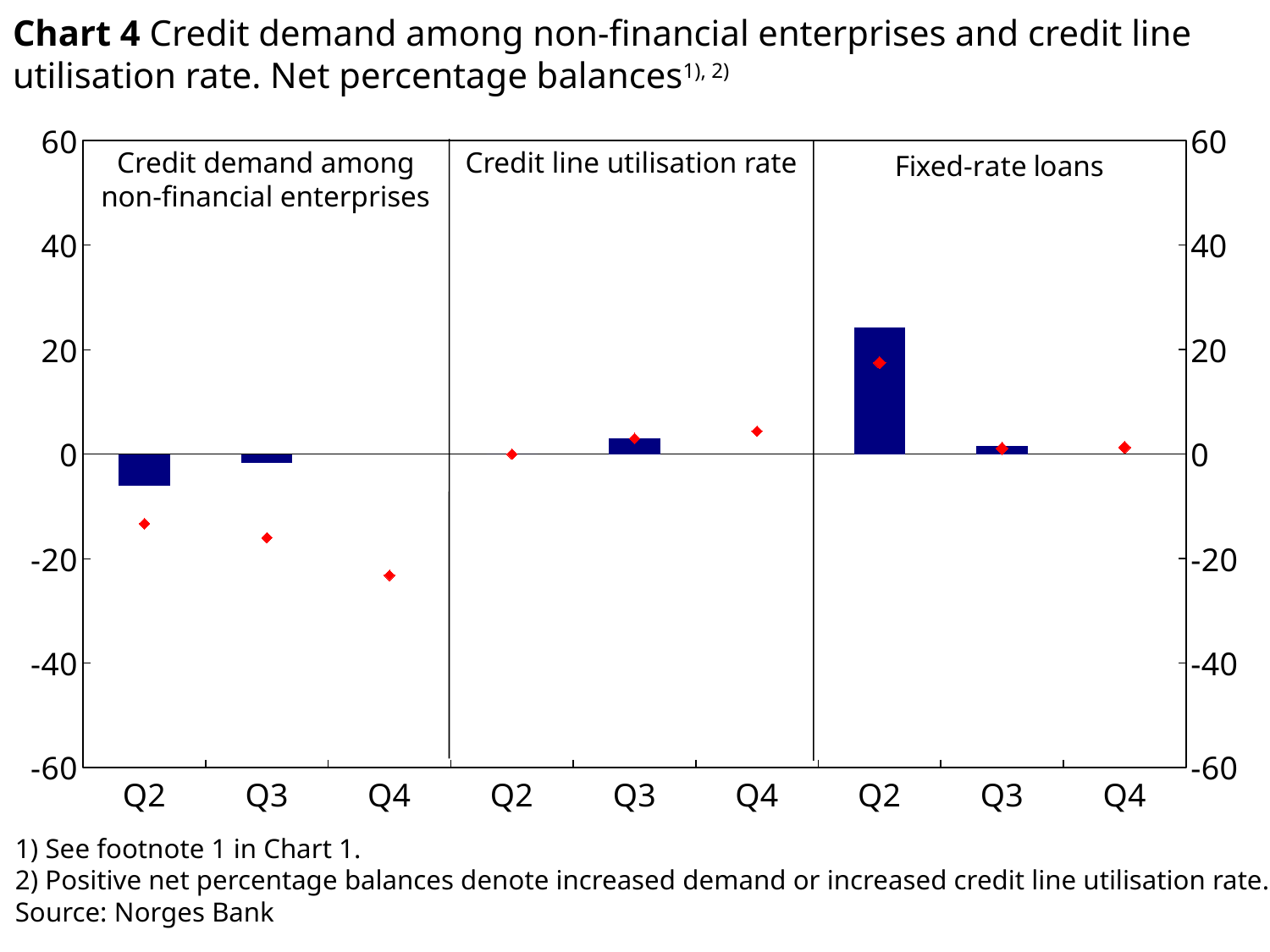
In the 'Fixed-rate loans' panel, is the red marker for Q2 greater or less than 10? greater In the 'Credit demand among non-financial enterprises' panel, is the red marker for Q4 greater or less than -20? less In the 'Fixed-rate loans' panel, which quarter has the tallest bar? Q2 Which is larger: the Q2 bar in the 'Fixed-rate loans' panel or the Q3 bar in the 'Credit line utilisation rate' panel? Q2 bar in Fixed-rate loans What is the source given for Chart 4? Norges Bank In the 'Fixed-rate loans' panel, is the bar for Q2 greater or less than 20? greater In the 'Credit demand among non-financial enterprises' panel, which quarter has the lowest red marker? Q4 What kind of chart is Chart 4? bar chart with red diamond markers How many panels (sections) does Chart 4 contain? 3 In the 'Credit demand among non-financial enterprises' panel, do the red markers rise or fall from Q2 to Q4? fall How many quarters are shown on the x axis of the 'Fixed-rate loans' panel? 3